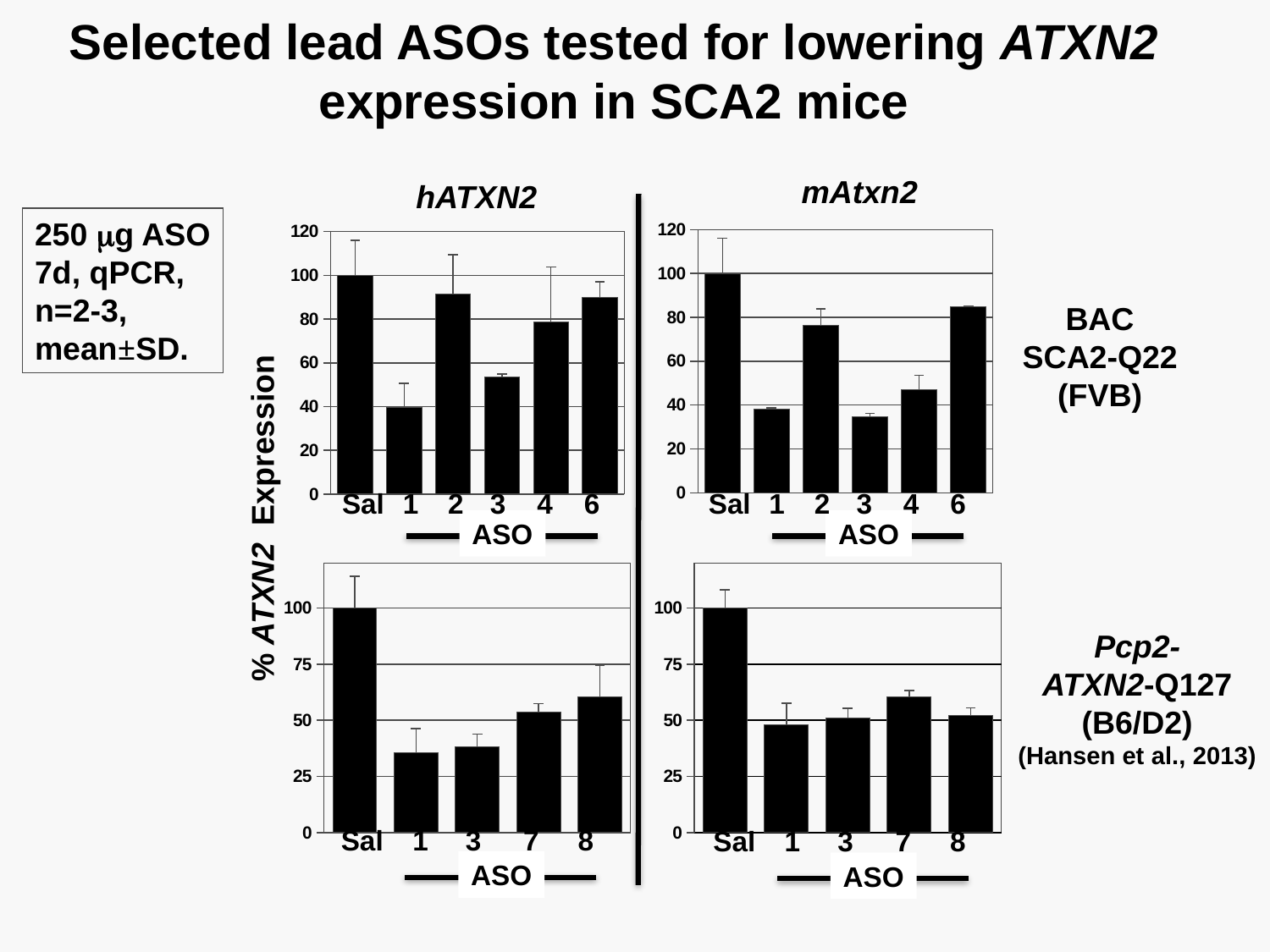
In the top-left hATXN2 chart, which category has the lowest value? 1 In the bottom-left hATXN2 chart, is the value for ASO 8 greater or less than 75? less In the top-left hATXN2 chart, what is the value for Sal? 100 What kind of chart is the top-left hATXN2 chart? bar chart In the bottom-right mAtxn2 chart, which is larger, the value for ASO 7 or ASO 1? ASO 7 What is the shared y-axis label for the charts? % ATXN2 Expression In the top-left hATXN2 chart, how many bars (categories) are plotted? 6 In the top-left hATXN2 chart, is the value for ASO 1 greater or less than 60? less In the bottom-left hATXN2 chart, how many bars (categories) are plotted? 5 In the top-right mAtxn2 chart, is the value for ASO 6 greater or less than 60? greater In the top-left hATXN2 chart, which is larger, the value for ASO 2 or ASO 3? ASO 2